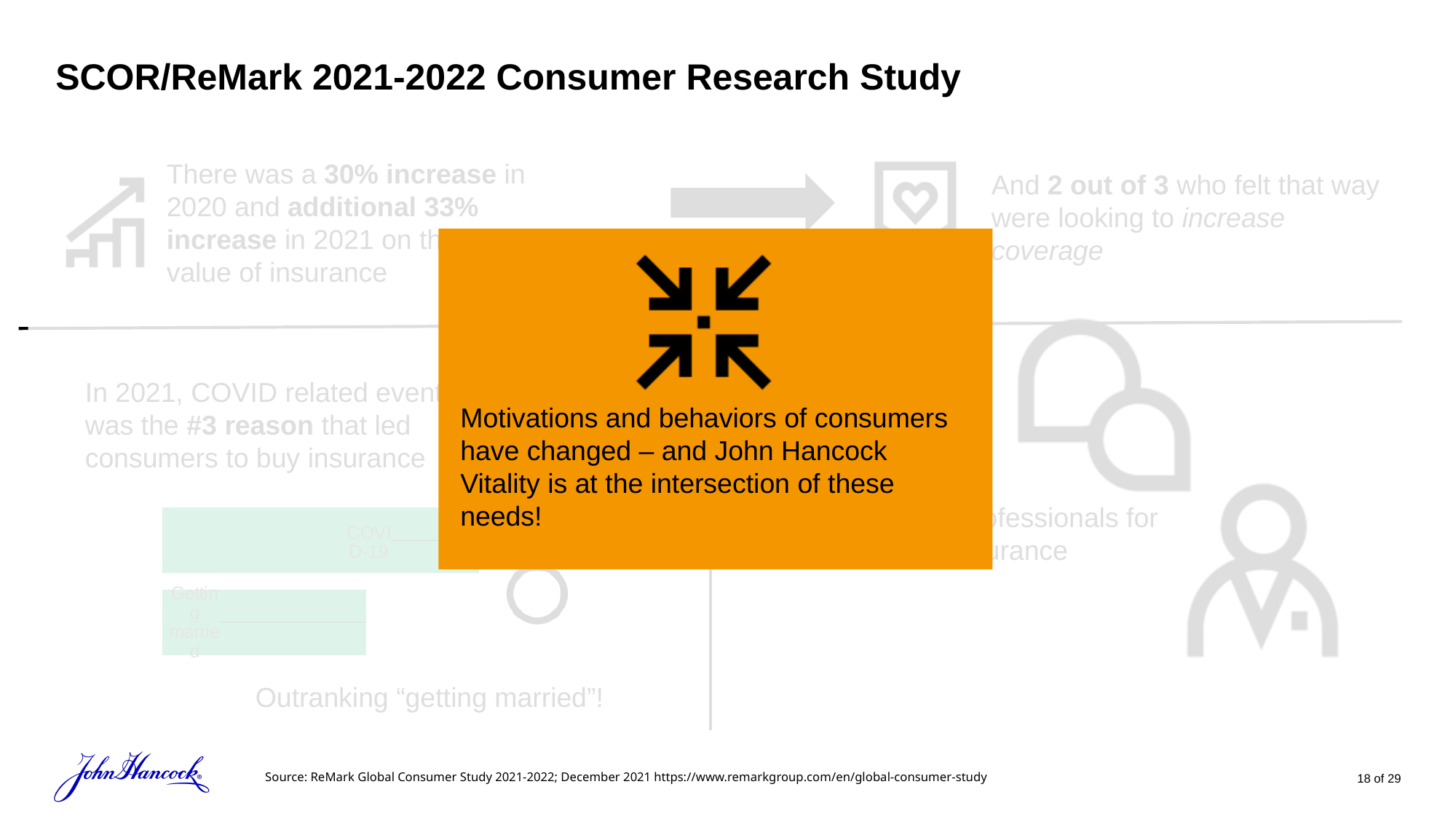
What kind of chart is shown in the lower left of the slide? bar chart In the chart in the lower left, which category has the highest value? COVID-19 In the chart in the lower left, which category has the longer bar, COVID-19 or Getting married? COVID-19 Are the bars in the chart in the lower left of the slide horizontal or vertical? horizontal How many bars does the chart in the lower left of the slide show? 2 In the chart in the lower left, which category has the lowest value? Getting married